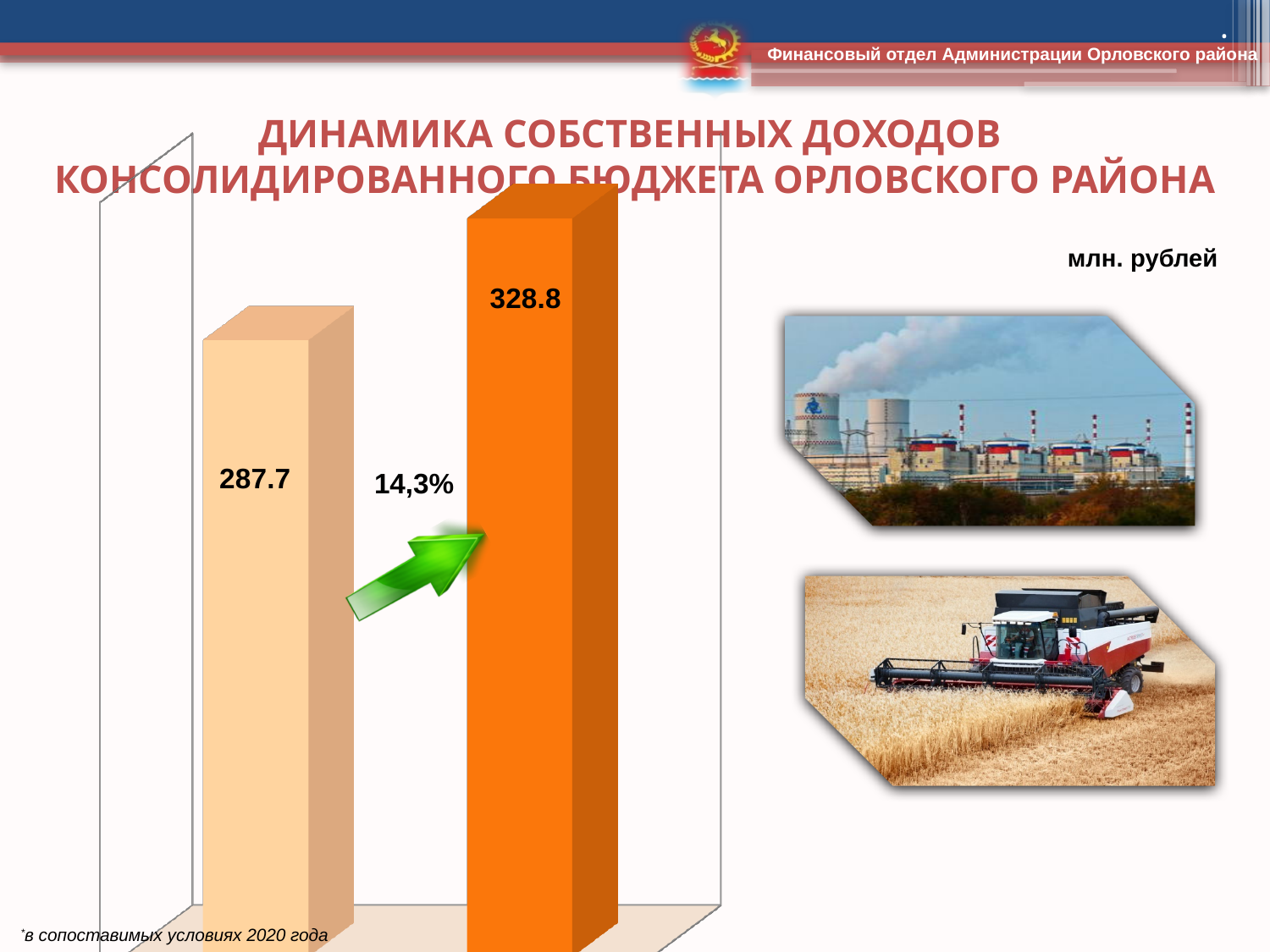
What is the value shown on the right (orange) bar? 328.8 Which bar has the lowest value, the left or the right one? The left bar (287.7) What is the value shown on the left (light orange) bar? 287.7 What percentage change is shown next to the green arrow between the two bars? 14,3% What kind of chart is shown on the slide? Bar chart Do the values rise or fall from the left bar to the right bar? Rise What is the difference between the values of the right bar and the left bar? 41.1 How many bars are plotted in the chart? 2 Which bar has the highest value, the left or the right one? The right bar (328.8) In what units are the chart values expressed, according to the label on the slide? млн. рублей Is the value of the right bar larger or smaller than the value of the left bar? Larger